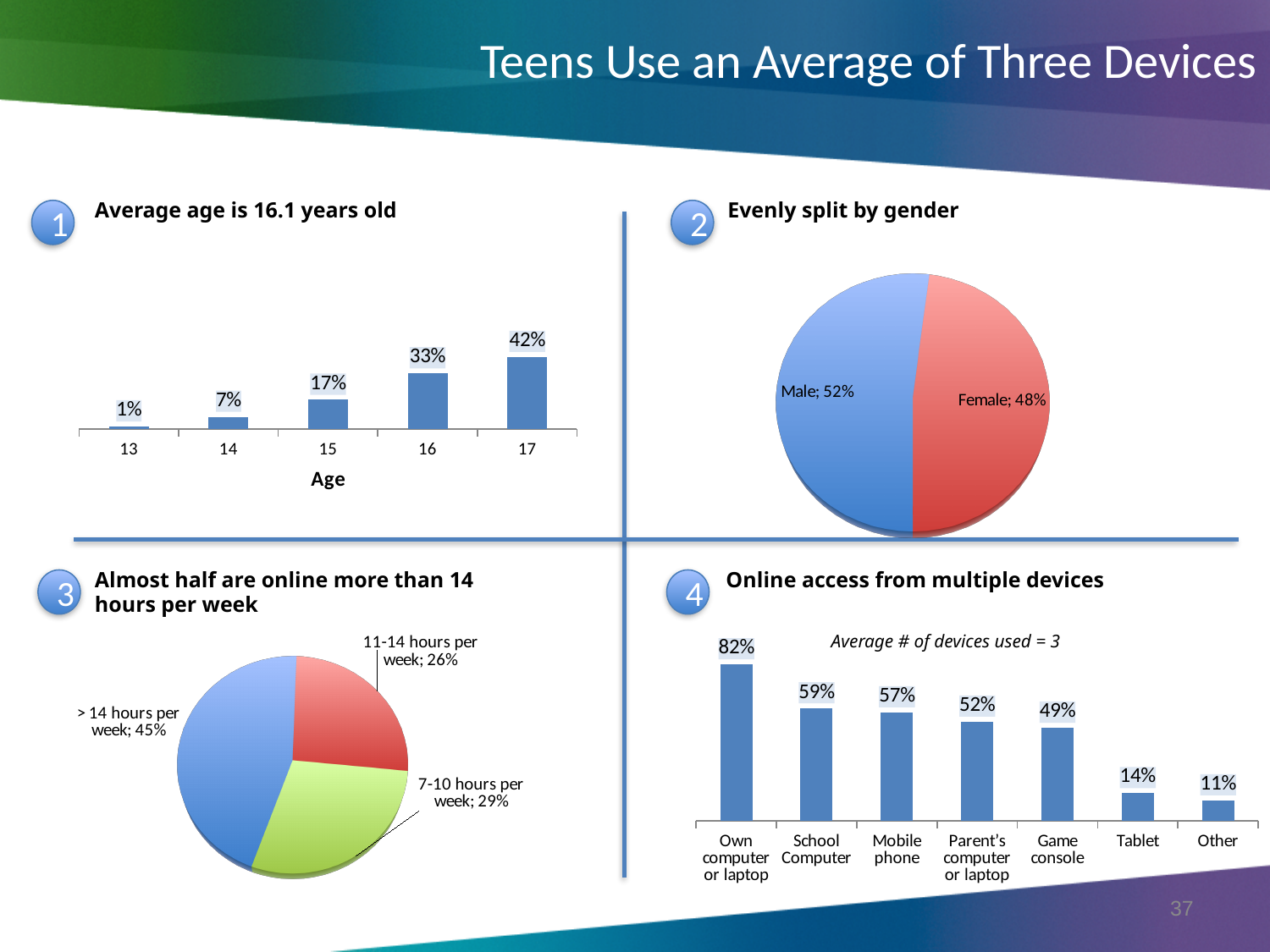
In the age bar chart (top left), which age has the lowest percentage? 13 In the online access bar chart (bottom right), which device has the highest percentage? Own computer or laptop In the online access bar chart (bottom right), what is the difference between Own computer or laptop and Tablet? 68% In the gender pie chart (top right), what share is Male? 52% In the hours-per-week pie chart (bottom left), how many slices are there? 3 In the age bar chart (top left), what is the difference between the percentages for age 16 and age 15? 16% In the age bar chart (top left), how many age categories are shown? 5 In the age bar chart (top left), do the values rise or fall as age increases from 13 to 17? rise In the online access bar chart (bottom right), what percentage is shown for Game console? 49% In the hours-per-week pie chart (bottom left), what share is '> 14 hours per week'? 45% In the gender pie chart (top right), which is larger, Male or Female? Male In the age bar chart (top left), what percentage of teens are age 17? 42%